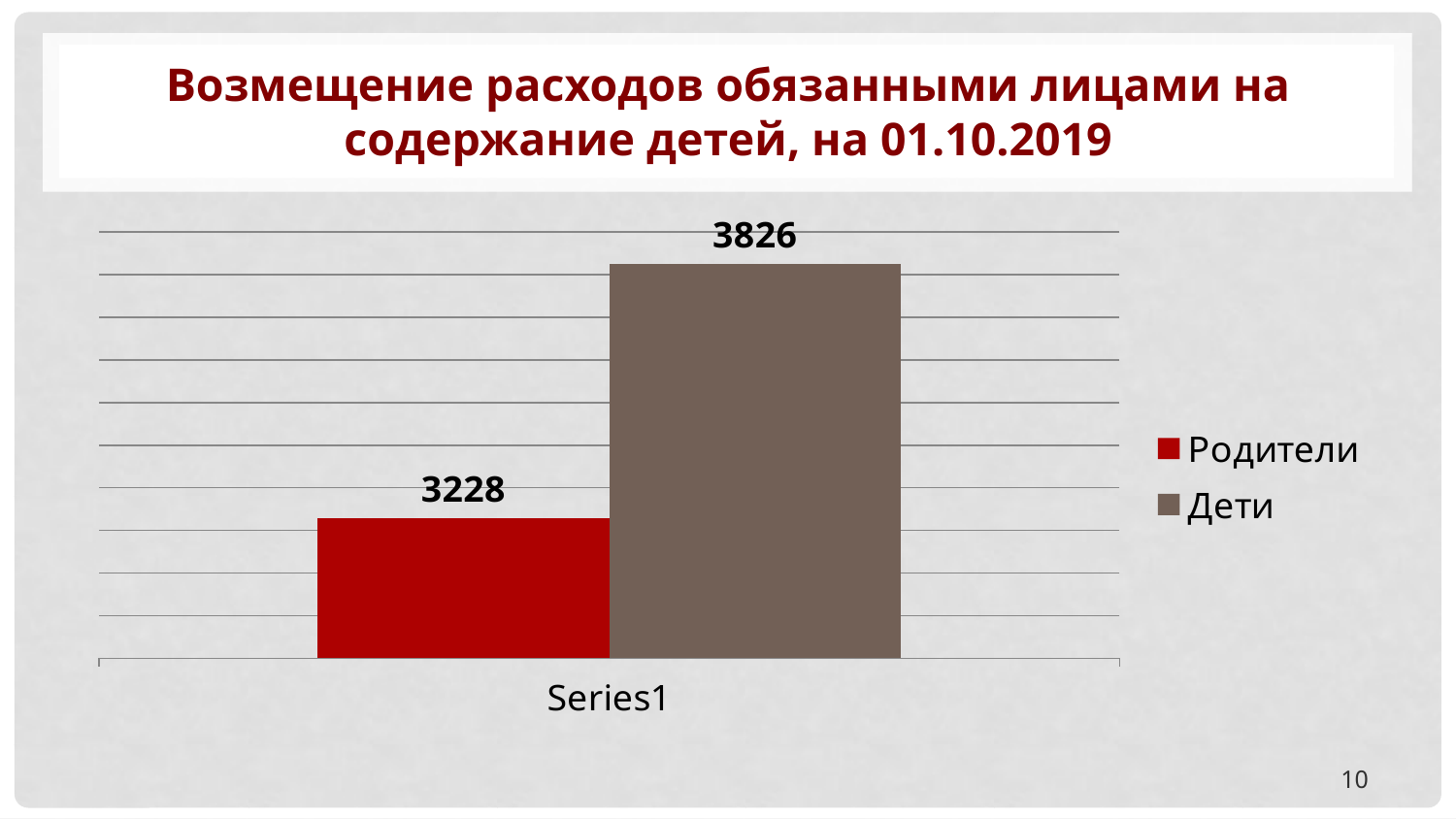
What kind of chart is shown on the slide? bar chart What is the value for Родители? 3228 What is the total of the two bar values? 7054 How many entries does the legend list? 2 What is the difference between the values for Дети and Родители? 598 Which legend entry has the higher value, Родители or Дети? Дети How many bars are plotted on the chart? 2 Is the value for Родители larger or smaller than the value for Дети? smaller What colour is the bar for Родители? red What is the value for Дети? 3826 Which legend entry has the lower value? Родители What label appears on the x axis under the bars? Series1